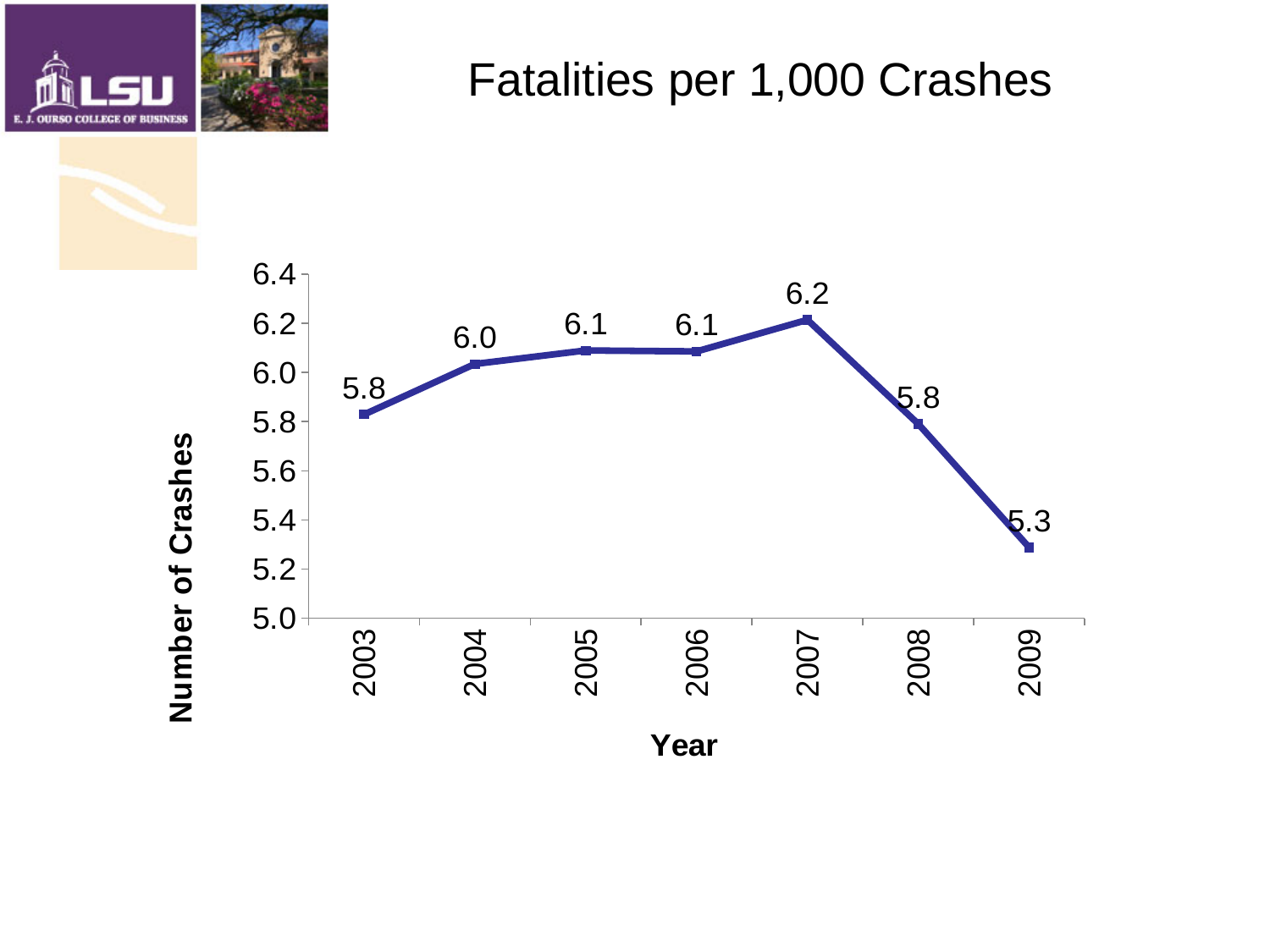
What is the value for 2007? 6.2 How many years are plotted on the chart? 7 What is the value for 2003? 5.8 Is the value for 2008 greater or less than 6.0? less What is the difference between the values for 2007 and 2009? 0.9 What is the value for 2004? 6.0 Which year has the highest value? 2007 Which year has the lowest value? 2009 What kind of chart is shown on the slide? line chart What is the value for 2009? 5.3 What is the title of the chart? Fatalities per 1,000 Crashes Which is larger, the value for 2004 or the value for 2009? 2004